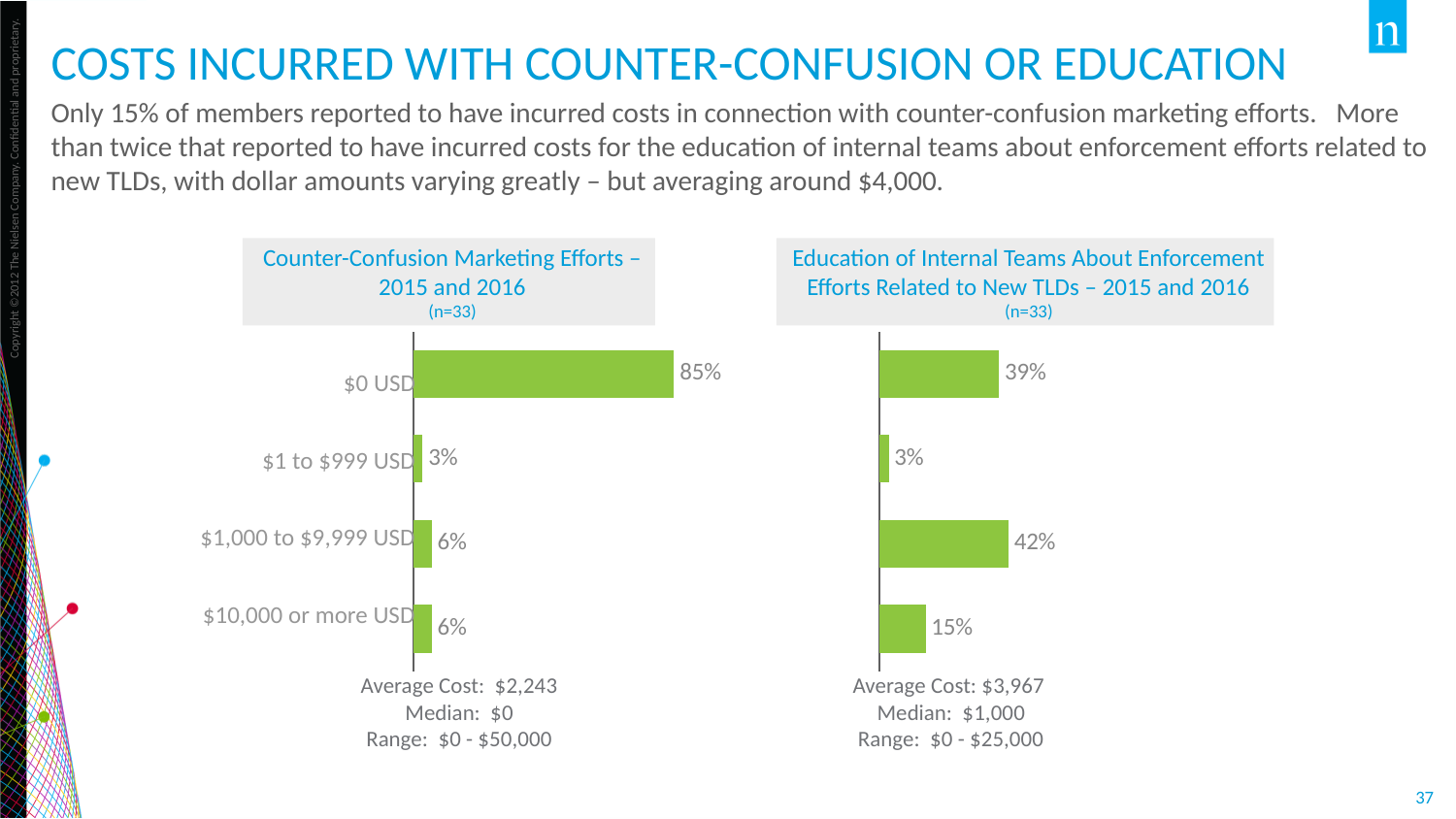
In the Education of Internal Teams chart, what is the difference in percentage points between the $1,000 to $9,999 USD category and the $0 USD category? 3 What is the sample size (n) shown for the Counter-Confusion Marketing Efforts chart? n=33 In the Education of Internal Teams chart, what percentage of members reported costs of $1,000 to $9,999 USD? 42% In the Education of Internal Teams chart, which cost category has the lowest percentage? $1 to $999 USD In the Counter-Confusion Marketing Efforts chart, what is the difference in percentage points between the $0 USD category and the $1 to $999 USD category? 82 What average cost is listed below the Education of Internal Teams chart? $3,967 What type of chart is used for the Education of Internal Teams About Enforcement Efforts data? Bar chart How many cost categories are shown in the Counter-Confusion Marketing Efforts chart? 4 In the Counter-Confusion Marketing Efforts chart, what percentage of members reported $0 USD in costs? 85% In the Counter-Confusion Marketing Efforts chart, which cost category has the highest percentage? $0 USD In the Education of Internal Teams chart, what percentage of members reported costs of $10,000 or more USD? 15% Which chart shows a larger percentage for the $10,000 or more USD category, the Counter-Confusion Marketing Efforts chart or the Education of Internal Teams chart? Education of Internal Teams chart